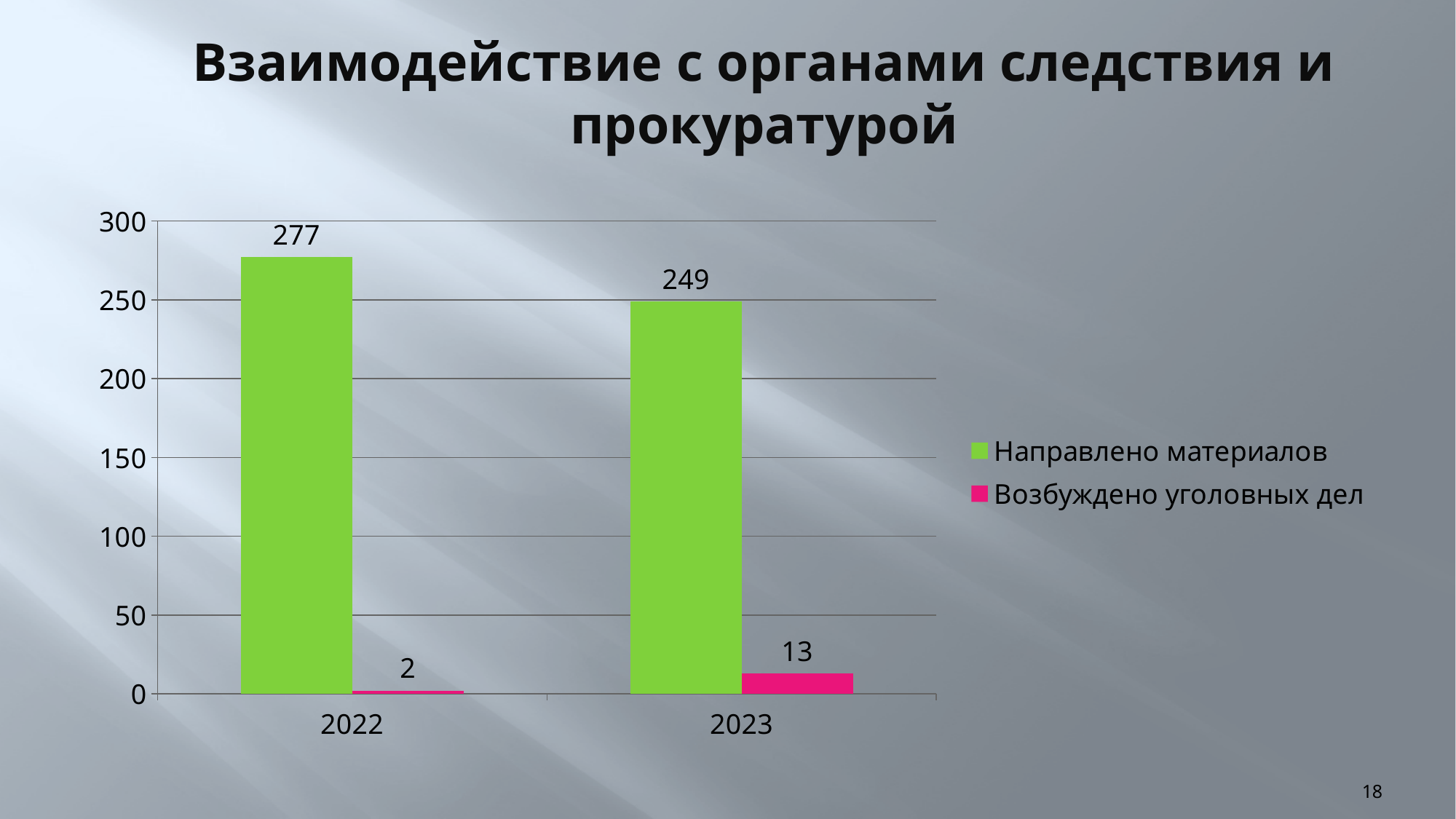
Which is larger: 'Возбуждено уголовных дел' in 2022 or in 2023? 2023 What is the value of 'Возбуждено уголовных дел' for 2023? 13 In which year is 'Направлено материалов' highest? 2022 Does 'Направлено материалов' rise or fall from 2022 to 2023? Fall By how much did 'Возбуждено уголовных дел' increase from 2022 to 2023? 11 What is the value of 'Направлено материалов' for 2022? 277 What kind of chart is shown on the slide? Bar chart What is the difference between 'Направлено материалов' in 2022 and 2023? 28 How many series does the legend list? 2 What is the value of 'Направлено материалов' for 2023? 249 In which year is 'Возбуждено уголовных дел' lowest? 2022 What is the value of 'Возбуждено уголовных дел' for 2022? 2